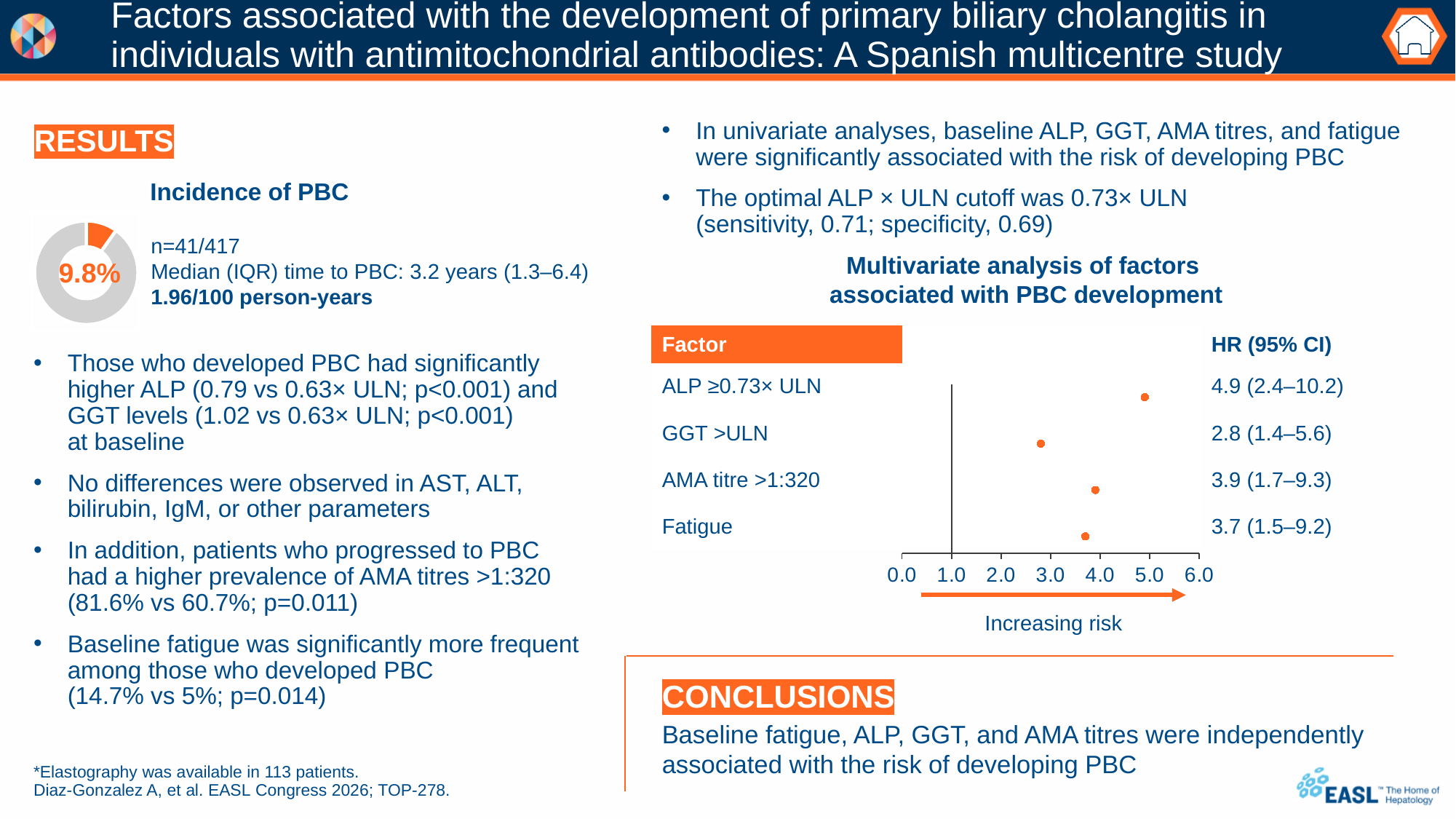
In the Multivariate analysis chart, what is the difference between the hazard ratios for ALP ≥0.73× ULN and GGT >ULN? 2.1 In the Multivariate analysis chart, what is the HR (95% CI) for GGT >ULN? 2.8 (1.4–5.6) What label appears under the arrow beneath the x-axis of the Multivariate analysis chart? Increasing risk In the Multivariate analysis chart, which factor has the lowest hazard ratio? GGT >ULN In the Multivariate analysis chart, is the hazard ratio for ALP ≥0.73× ULN greater or less than 4.0? greater How many factors are plotted in the Multivariate analysis chart? 4 In the Multivariate analysis chart, what is the HR (95% CI) for Fatigue? 3.7 (1.5–9.2) In the Multivariate analysis chart, what is the HR (95% CI) for AMA titre >1:320? 3.9 (1.7–9.3) In the Multivariate analysis chart, which has the larger hazard ratio: AMA titre >1:320 or Fatigue? AMA titre >1:320 What share of the Incidence of PBC donut chart is highlighted in orange? 9.8% In the Multivariate analysis chart, what is the HR (95% CI) for ALP ≥0.73× ULN? 4.9 (2.4–10.2) In the Multivariate analysis chart, which factor has the highest hazard ratio? ALP ≥0.73× ULN